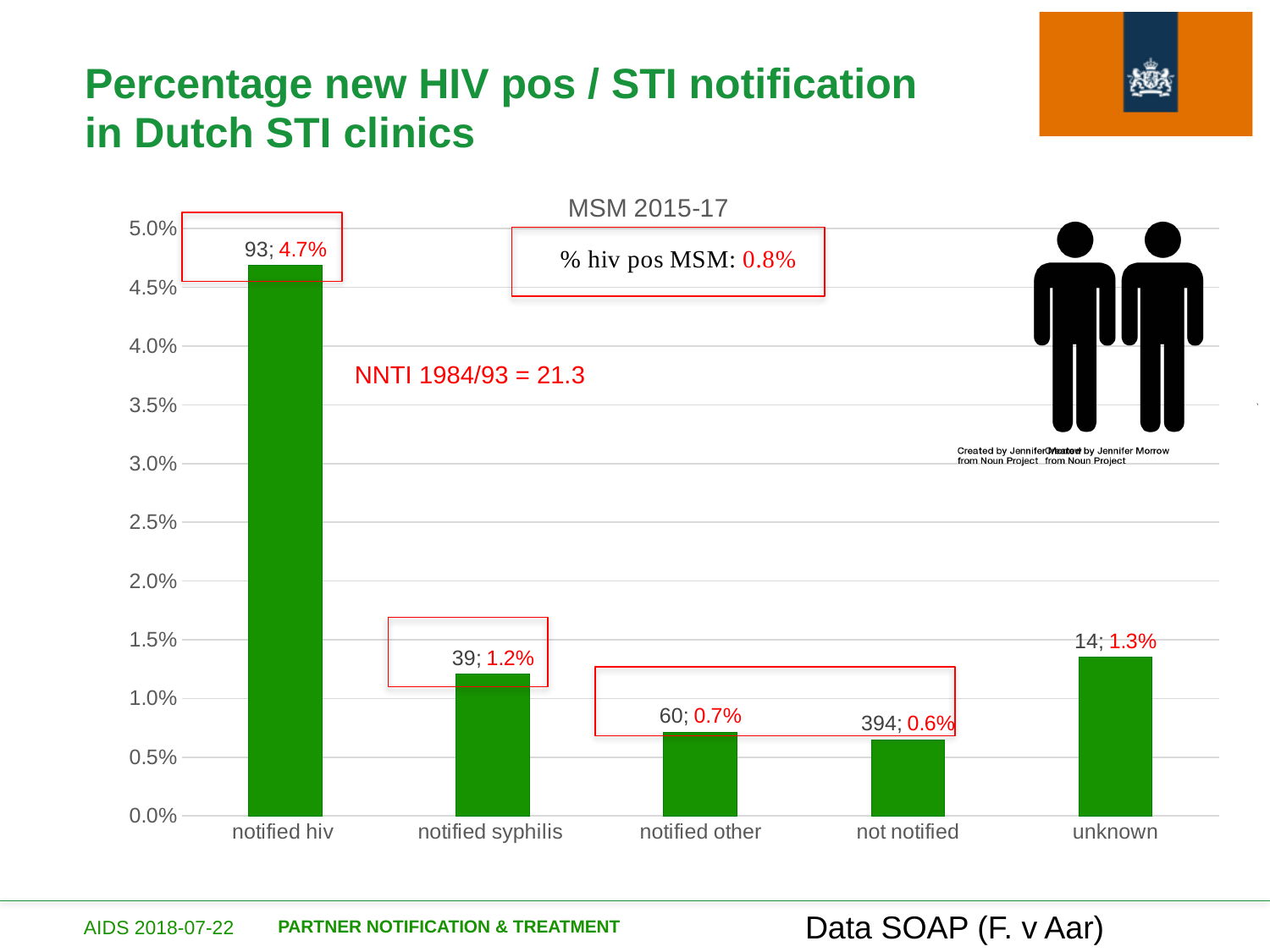
Which is larger, the percentage for 'notified hiv' or for 'unknown'? notified hiv Is the value for 'notified other' greater or less than 1.0%? less What percentage is shown for the 'notified hiv' bar? 4.7% Which category has the highest percentage? notified hiv What percentage is shown for the 'unknown' bar? 1.3% What count is printed in the data label for 'not notified'? 394 How many categories are shown on the x axis? 5 What is the difference in percentage between 'notified hiv' and 'notified syphilis'? 3.5% What is the title of the chart? MSM 2015-17 Which category has the lowest percentage? not notified What percentage is shown for the 'not notified' bar? 0.6% What kind of chart is shown on the slide? bar chart